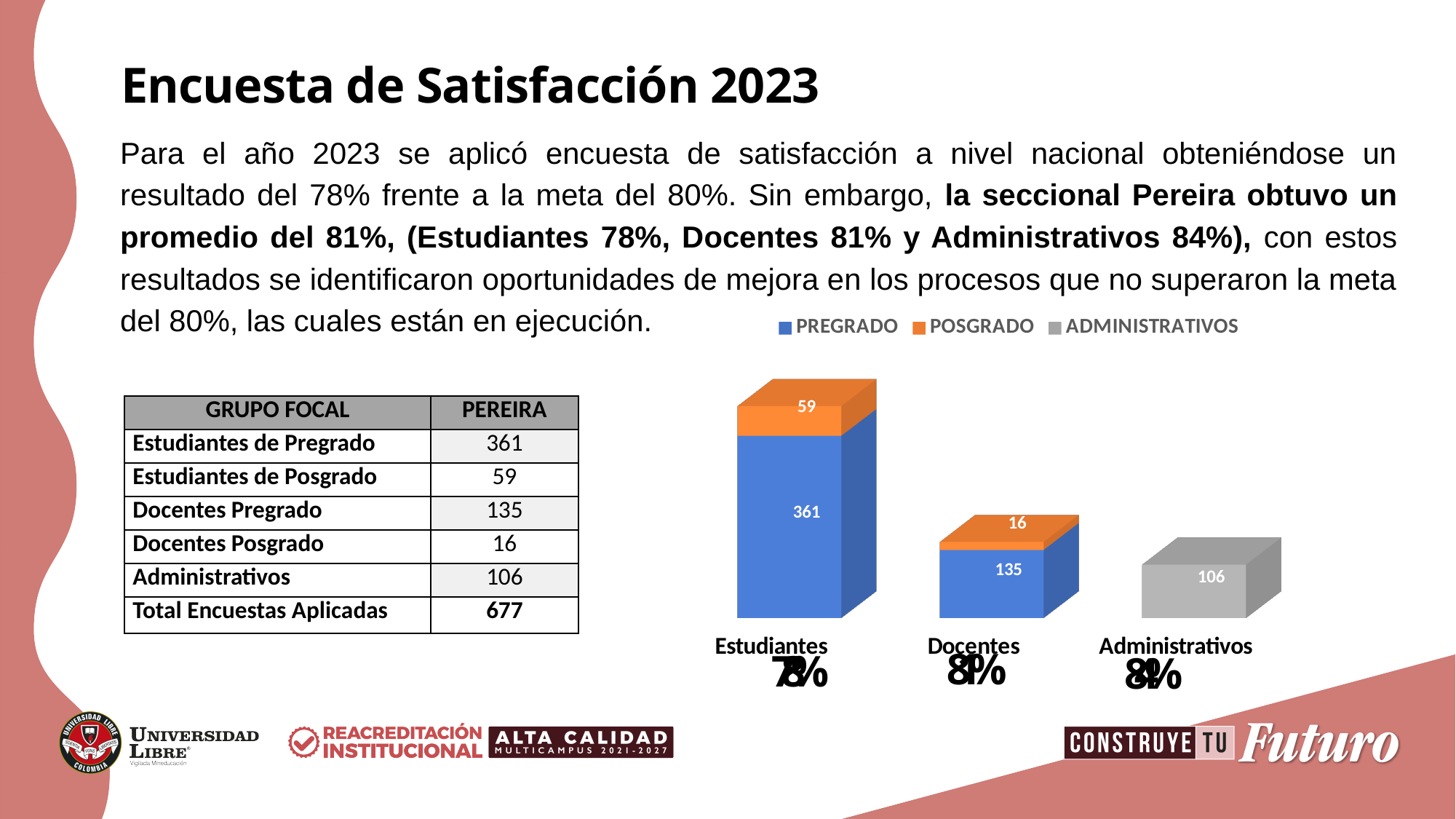
What is the difference between the PREGRADO values for Estudiantes and Docentes? 226 What is the POSGRADO value for Estudiantes in the chart? 59 What is the PREGRADO value for Docentes in the chart? 135 What kind of chart is shown on the slide? stacked bar chart What is the value shown for Administrativos in the chart? 106 How many categories are shown on the x axis of the chart? 3 What is the PREGRADO value for Estudiantes in the chart? 361 Which category has the tallest stacked bar in the chart? Estudiantes What is the POSGRADO value for Docentes in the chart? 16 What is the total of the stacked bar for Docentes? 151 What is the total of the stacked bar for Estudiantes? 420 How many series does the chart legend list? 3